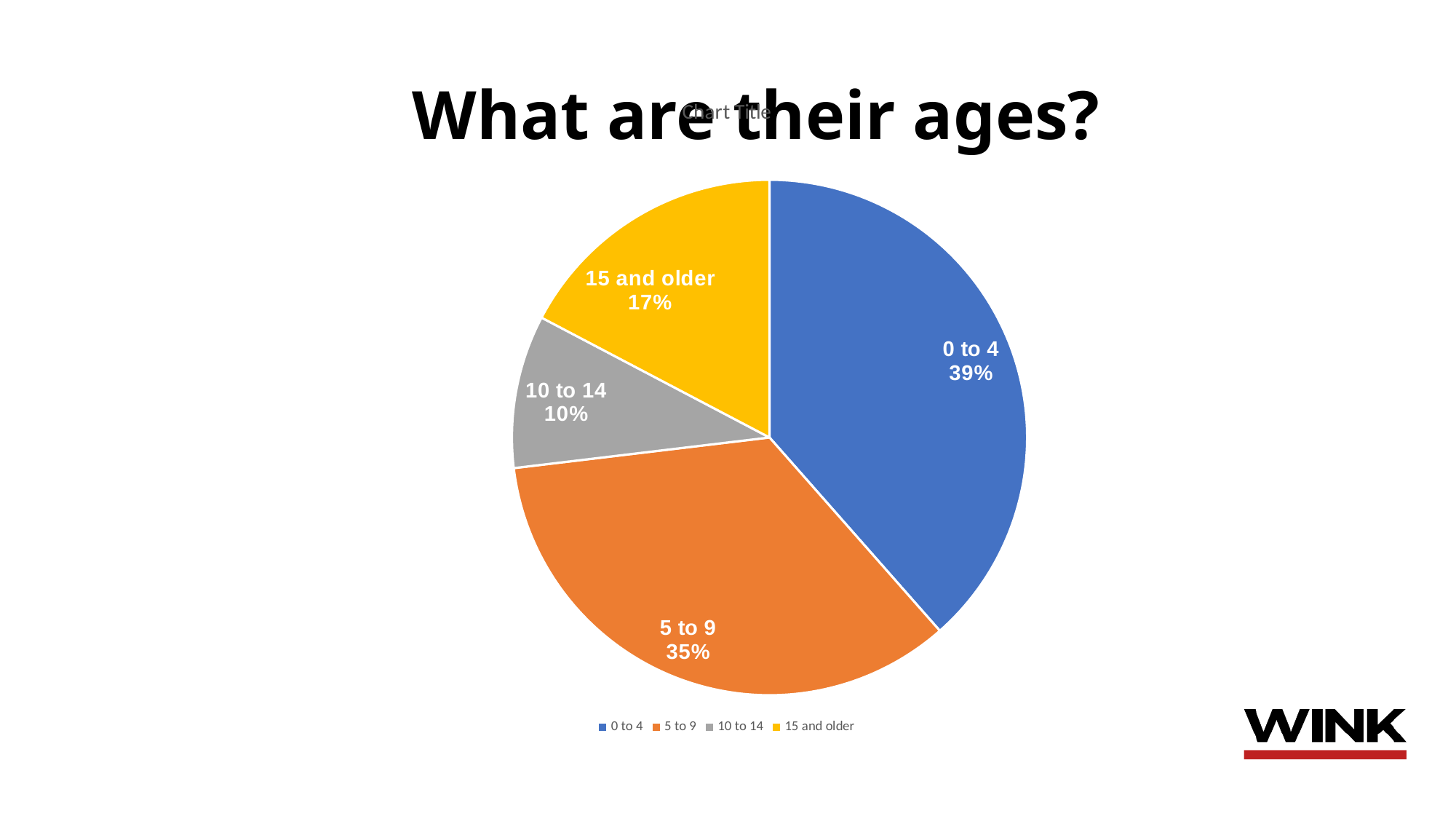
Which slice is larger: 15 and older or 10 to 14? 15 and older What percentage is shown for the 10 to 14 age group? 10% Which age group has the smallest share of the pie? 10 to 14 What is the difference in percentage points between the 0 to 4 and 5 to 9 slices? 4 What percentage is shown for the 5 to 9 age group? 35% What is the combined percentage of the 10 to 14 and 15 and older slices? 27% Which age group has the largest share of the pie? 0 to 4 What percentage of the pie is the 0 to 4 age group? 39% What type of chart is shown on the slide? pie chart How many age groups are shown in the pie chart? 4 What percentage is shown for the 15 and older age group? 17% What colour is the slice for the 5 to 9 age group? orange